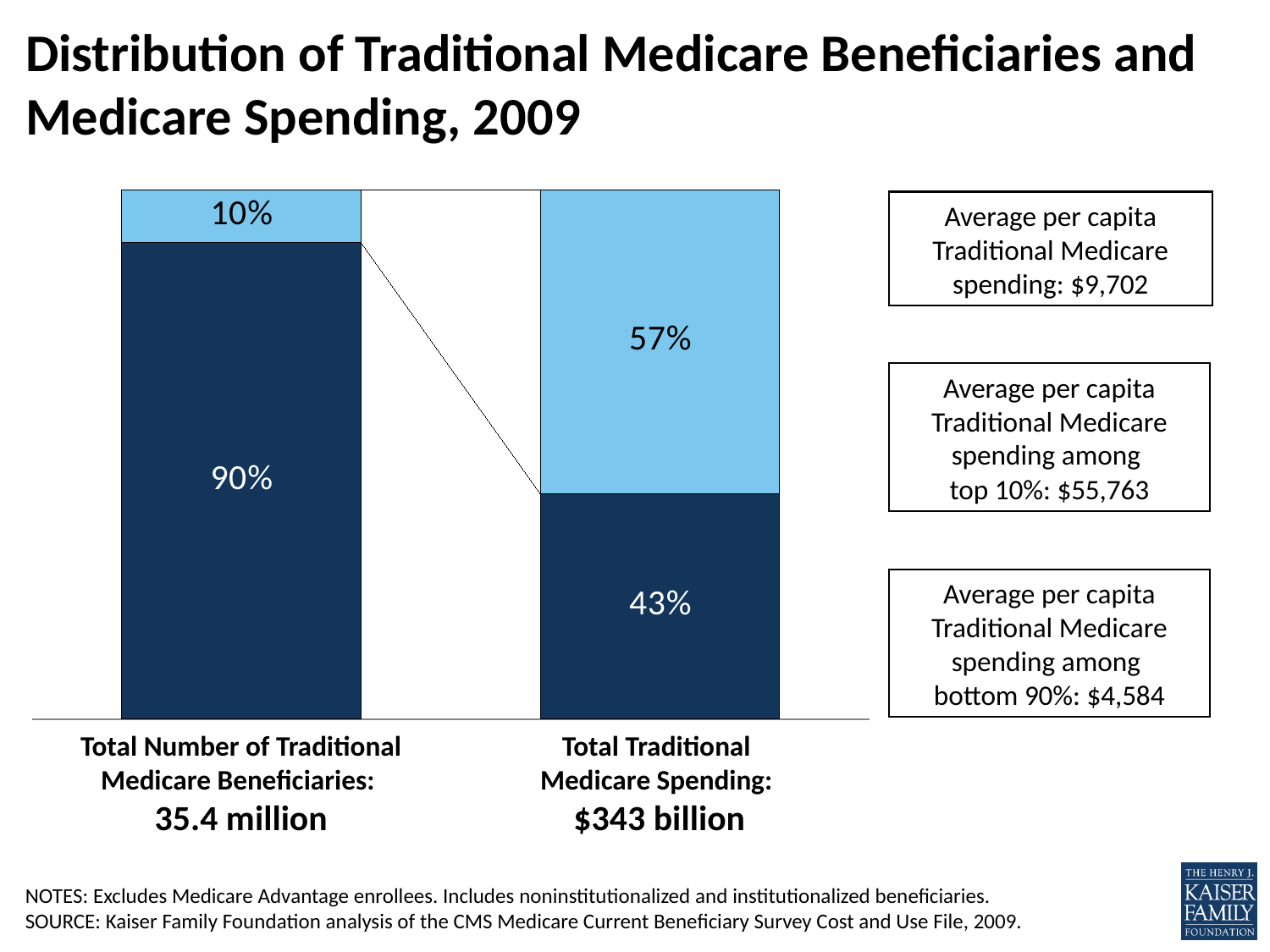
What share of Total Traditional Medicare Spending is shown in the light blue (top) segment? 57% What is the difference between the dark blue segments of the two bars (90% vs 43%)? 47 percentage points In the Total Traditional Medicare Spending bar, which segment is larger, the light blue or the dark blue? Light blue What is the difference between the light blue segment of the Total Traditional Medicare Spending bar and the light blue segment of the Total Number of Traditional Medicare Beneficiaries bar? 47 percentage points How many bars are plotted in the chart? 2 What total is printed beneath the Total Number of Traditional Medicare Beneficiaries bar? 35.4 million What total is printed beneath the Total Traditional Medicare Spending bar? $343 billion What share of Total Number of Traditional Medicare Beneficiaries is shown in the light blue (top) segment? 10% What share of Total Traditional Medicare Spending is shown in the dark blue (bottom) segment? 43% What is the title of the chart on the slide? Distribution of Traditional Medicare Beneficiaries and Medicare Spending, 2009 What share of Total Number of Traditional Medicare Beneficiaries is shown in the dark blue (bottom) segment? 90% What kind of chart is shown on the slide? Stacked bar chart